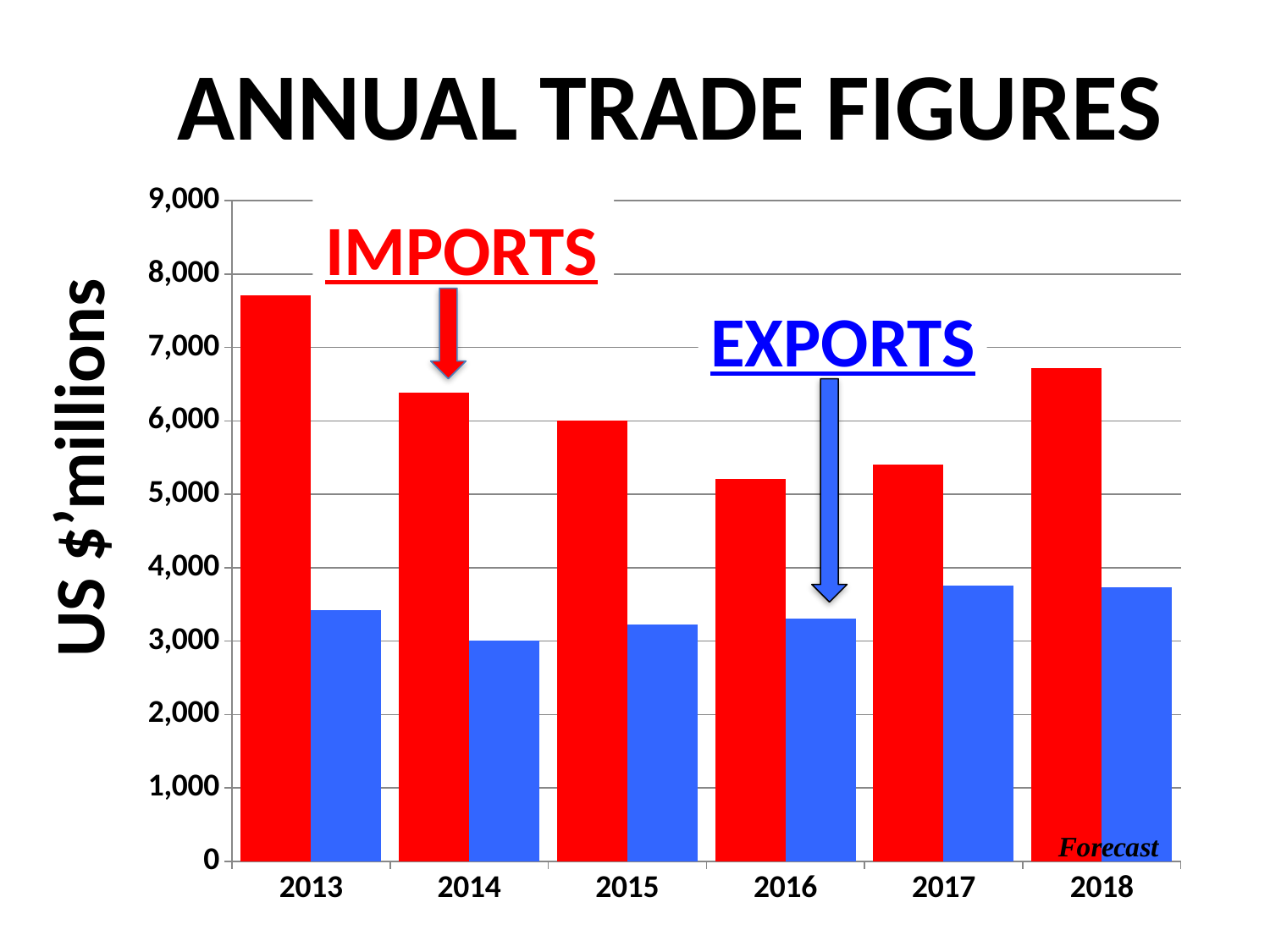
How many years are shown on the x axis of the chart? 6 In 2016, which is larger, Imports or Exports? Imports Is the value for Imports in 2018 greater or less than 7,000? less What kind of chart is shown on the slide? bar chart Do the Imports values rise or fall from 2013 to 2016? fall Which year has the lowest value for Imports? 2016 How many data series does the chart show? 2 Which year on the chart is labelled as a Forecast? 2018 Is the value for Exports in 2017 greater or less than 4,000? less Which year has the lowest value for Exports? 2014 Which year has the highest value for Imports? 2013 Is the value for Imports in 2013 greater or less than 7,000? greater